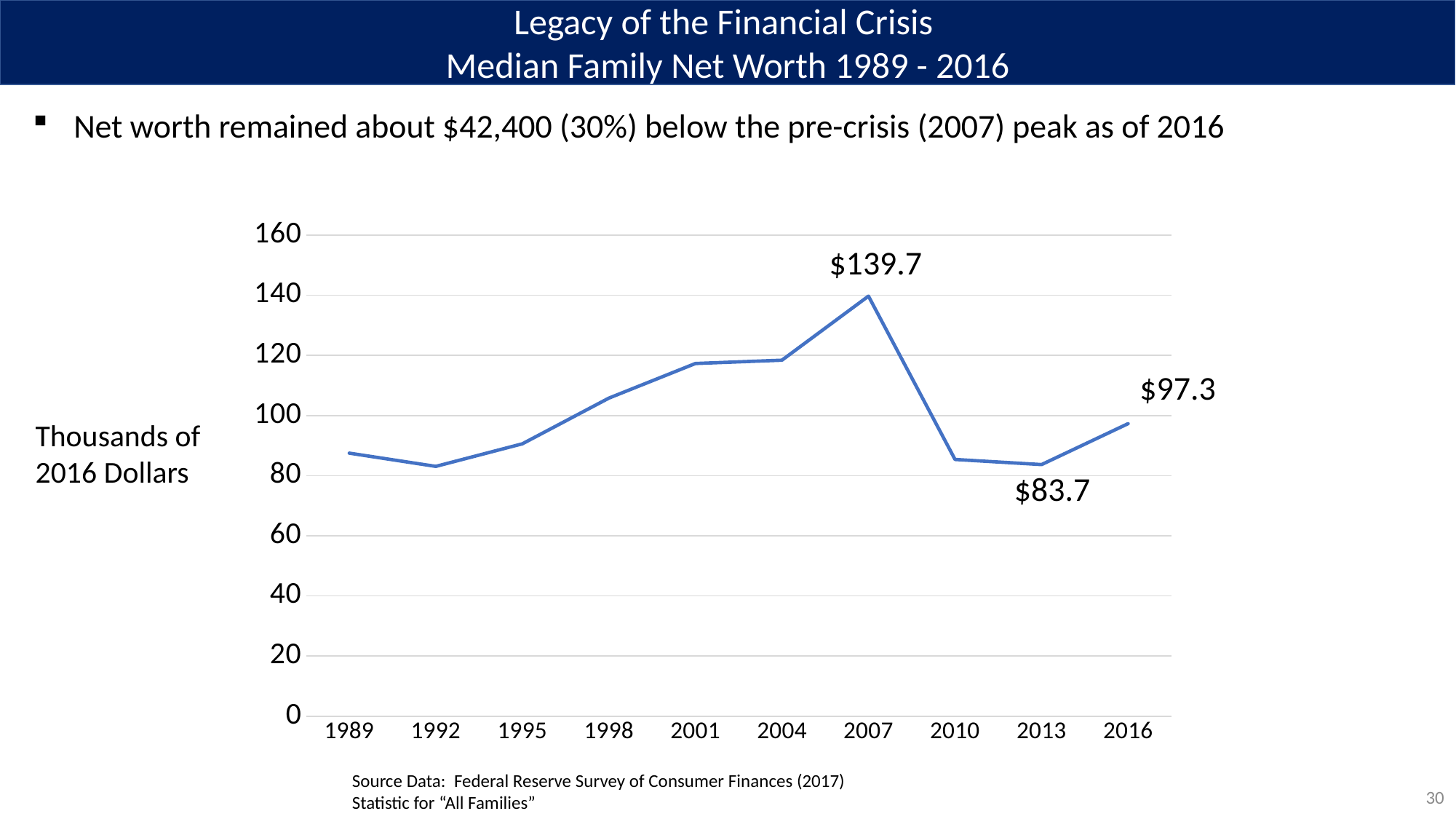
What is the difference between the labeled values for 2016 and 2013? $13.6 How many years are shown on the x axis? 10 Is the value for 1992 greater or less than 100? less What kind of chart is shown on the slide? line chart Which year has the highest median family net worth? 2007 Does the value rise or fall from 2007 to 2010? fall Which is larger, the value for 2001 or the value for 1995? 2001 What is the difference between the labeled values for 2007 and 2016? $42.4 What is the median family net worth value labeled for 2013? $83.7 What is the median family net worth value labeled for 2007? $139.7 What is the median family net worth value labeled for 2016? $97.3 Is the value for 2004 greater or less than 100? greater